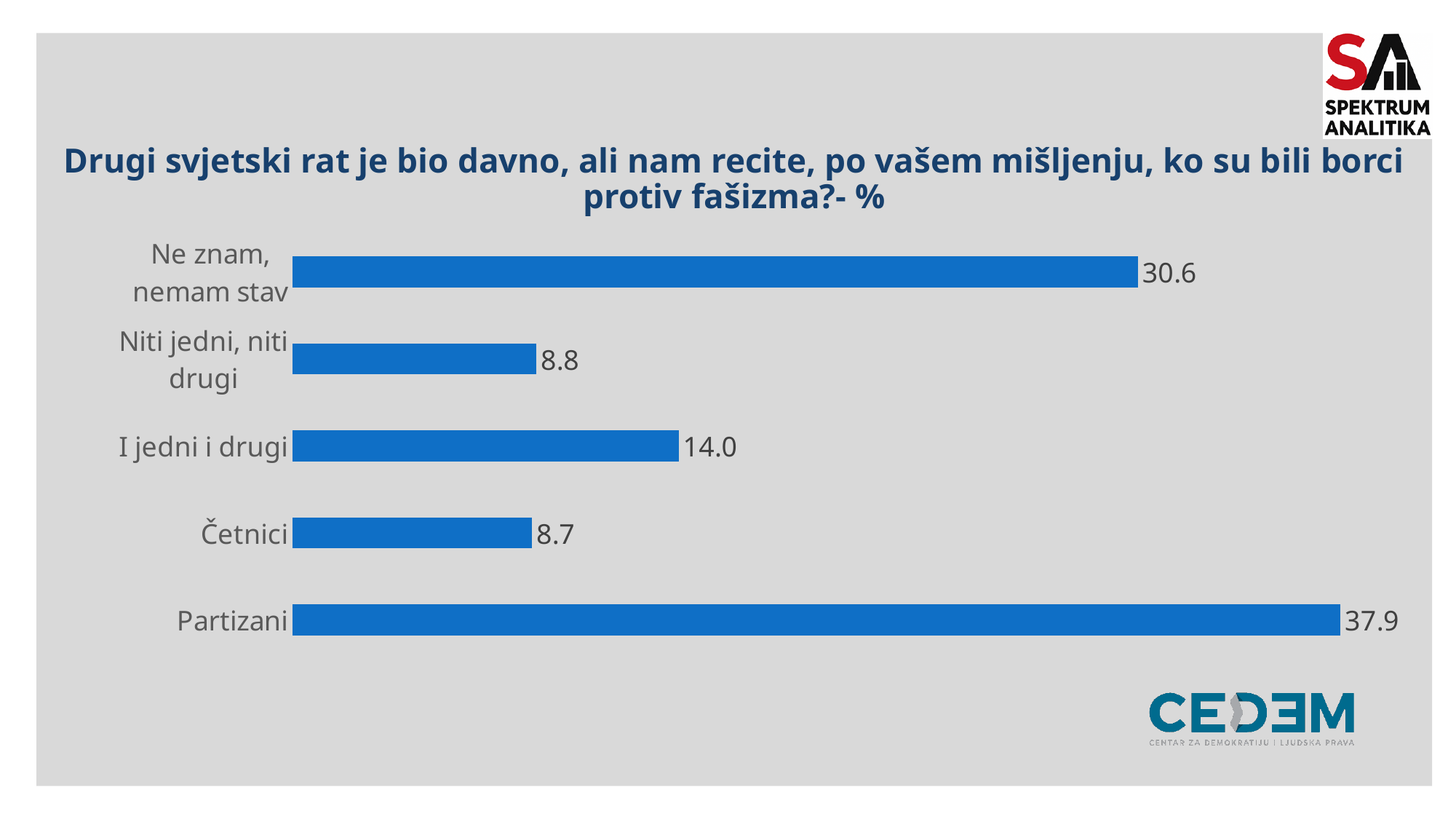
What is the value for Četnici? 8.7 What is the value for Partizani? 37.9 What is the difference between the values for I jedni i drugi and Niti jedni, niti drugi? 5.2 Which is larger, the value for I jedni i drugi or the value for Niti jedni, niti drugi? I jedni i drugi What colour are the bars in the chart? blue What kind of chart is shown on the slide? bar chart How many categories are shown in the chart? 5 What is the value for I jedni i drugi? 14.0 What is the difference between the values for Partizani and Ne znam, nemam stav? 7.3 Which category has the highest value? Partizani What is the value for Ne znam, nemam stav? 30.6 Which category has the lowest value? Četnici